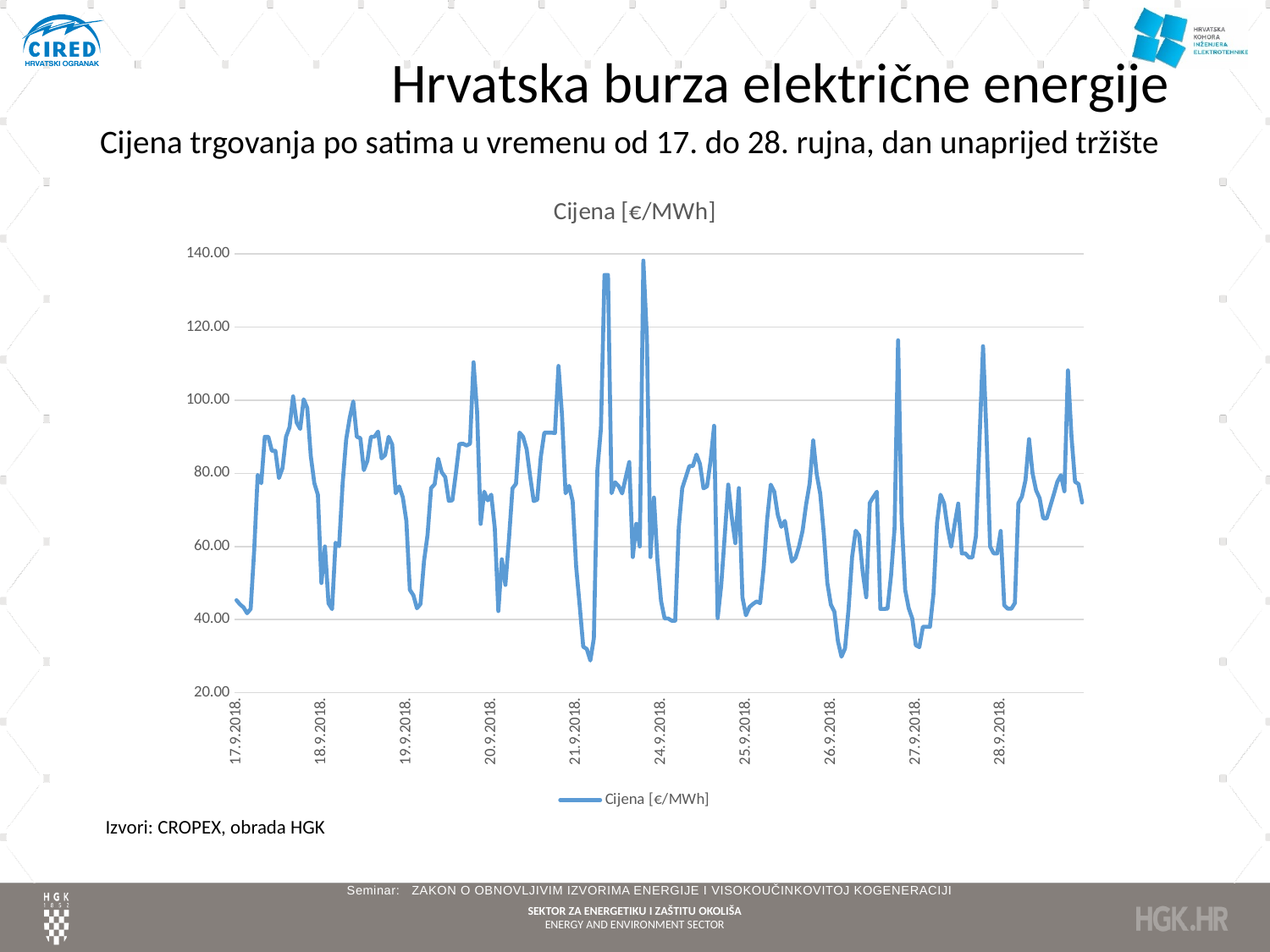
What is the name of the series shown in the legend? Cijena [€/MWh] What is the title of the chart? Cijena [€/MWh] Is the peak of the line near 27.9.2018 greater or less than 100.00? greater Is the peak of the line shortly after 21.9.2018 greater or less than 120.00? greater How many series does the legend list? 1 What kind of chart is shown on the slide? line chart Is the value at the very start of the line on 17.9.2018 greater or less than 60.00? less How many date labels are shown on the x axis? 10 What is the highest value shown on the y axis? 140.00